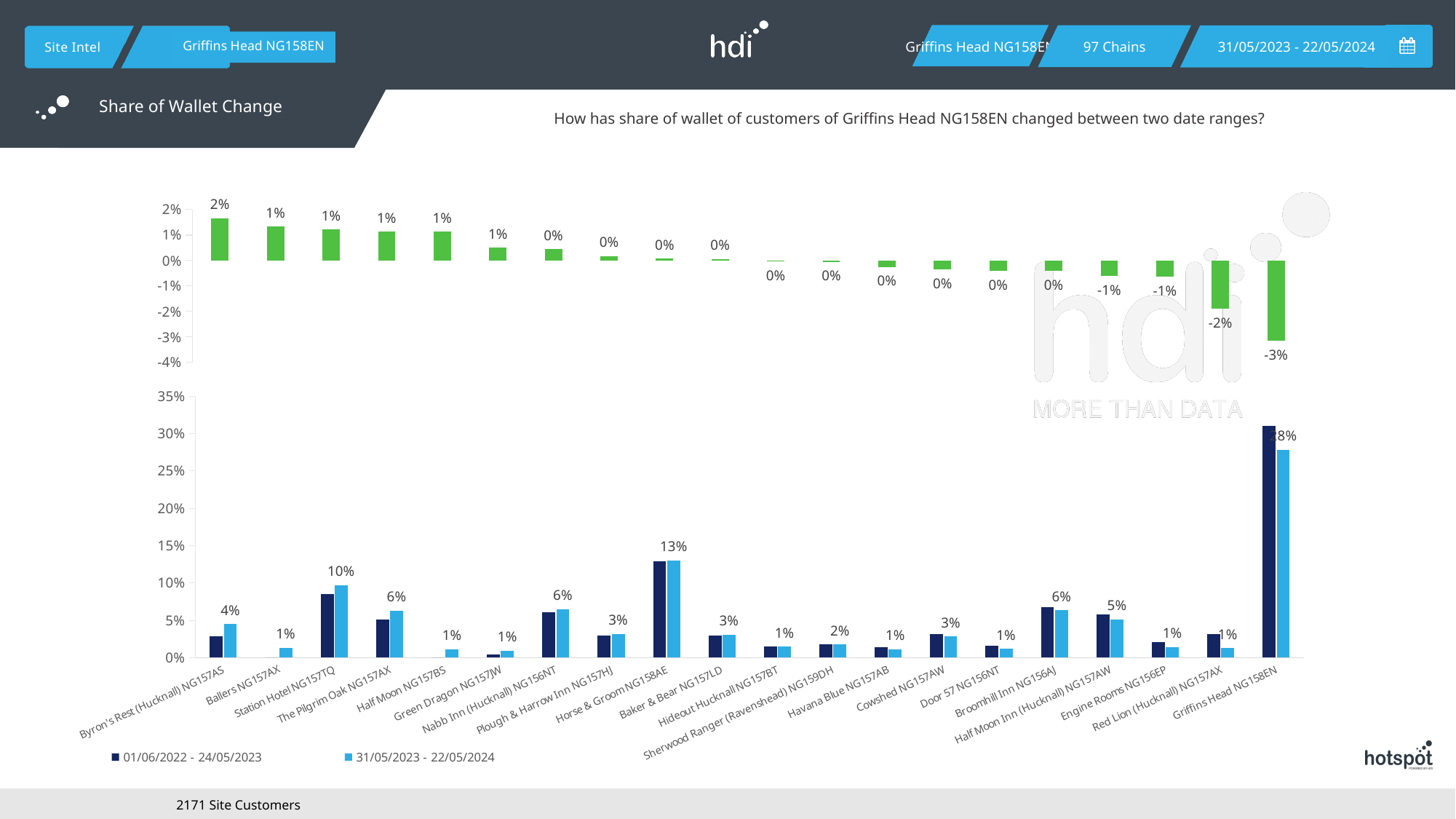
In the top chart (share of wallet change), what is the value for Red Lion (Hucknall) NG157AX? -2% In the bottom chart, what is the difference between the labelled values for Horse & Groom NG158AE and Station Hotel NG157TQ? 3% In the bottom chart, is the 01/06/2022 - 24/05/2023 value for Station Hotel NG157TQ greater or less than 5%? greater In the top chart (share of wallet change), which venue has the highest value? Byron's Rest (Hucknall) NG157AS What kind of chart is the bottom chart? Bar chart In the bottom chart, what is the labelled value for Station Hotel NG157TQ? 10% In the bottom chart, which venue has the highest share of wallet? Griffins Head NG158EN How many venues are shown on the x axis of the bottom chart? 20 In the bottom chart, what is the labelled value for Horse & Groom NG158AE? 13% In the top chart (share of wallet change), which venue has the lowest value? Griffins Head NG158EN How many series does the legend of the bottom chart list? 2 In the top chart (share of wallet change), what is the value for Griffins Head NG158EN? -3%